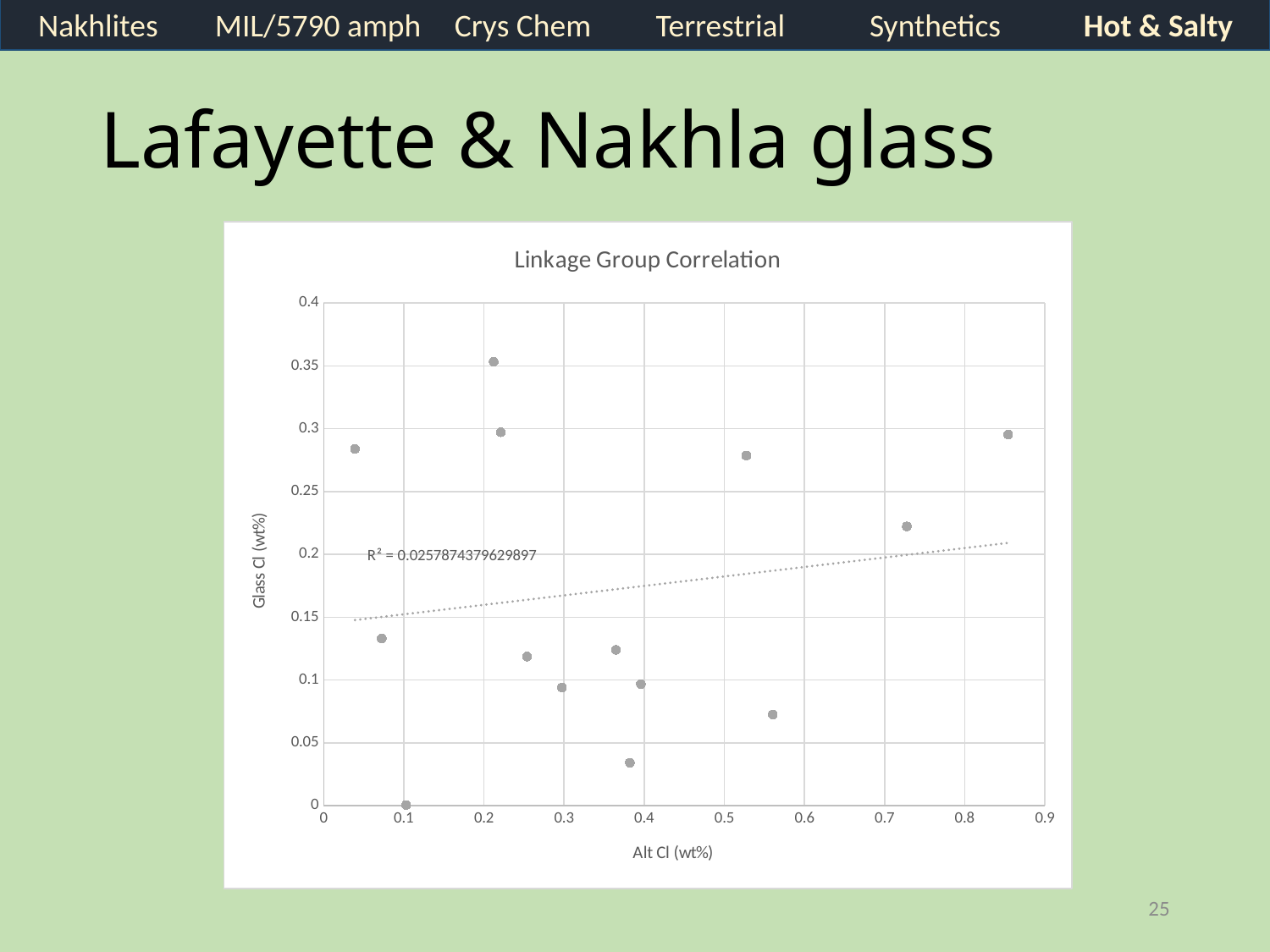
How many points have a Glass Cl (wt%) value above 0.25? 5 What kind of chart is shown on the slide? Scatter chart Is the Glass Cl (wt%) value of the point near Alt Cl 0.56 greater or less than 0.1? less Which has the higher Glass Cl (wt%) value: the point near Alt Cl 0.21 or the point near Alt Cl 0.52? The point near Alt Cl 0.21 What is the title of the chart? Linkage Group Correlation What R² value is printed on the chart? R² = 0.0257874379629897 Is the Alt Cl (wt%) value of the rightmost point greater or less than 0.8? greater Is the Glass Cl (wt%) value of the lowest point on the chart greater or less than 0.05? less Does the dotted trendline rise or fall as Alt Cl (wt%) increases? Rises How many data points are plotted on the chart? 14